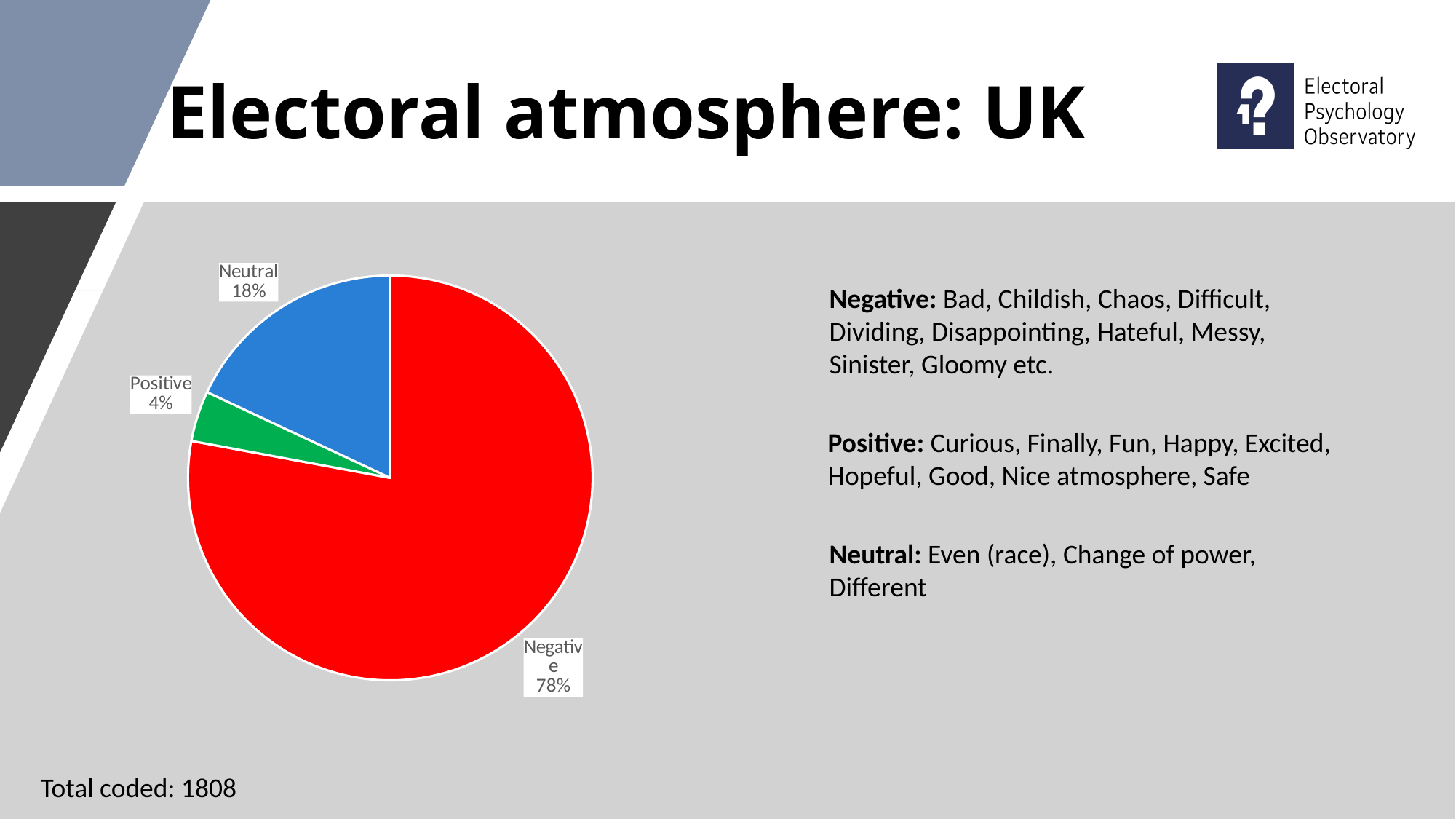
What share of the pie is Positive? 4% What is the total number of responses coded, as stated on the slide? 1808 What colour is the Negative slice of the pie? Red What share of the pie is Negative? 78% What is the difference in percentage points between the Negative and Neutral slices? 60 What kind of chart is shown on the slide? Pie chart Which is larger, the Neutral slice or the Positive slice? Neutral Which category has the smallest slice of the pie? Positive What is the difference in percentage points between the Neutral and Positive slices? 14 What share of the pie is Neutral? 18% Which category has the largest slice of the pie? Negative How many categories are shown in the pie chart? 3